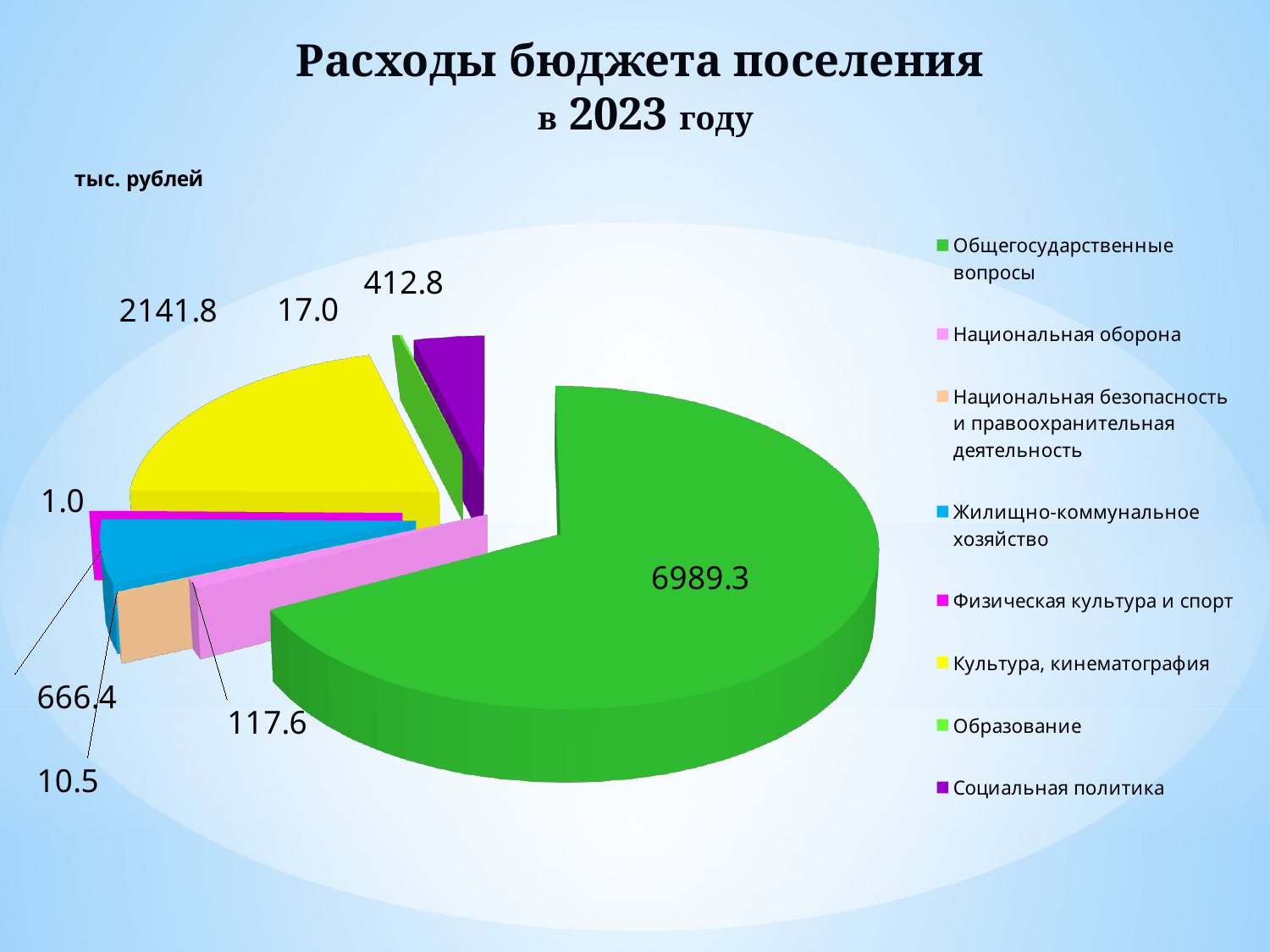
What is the value for Социальная политика? 412.8 What is the value for Жилищно-коммунальное хозяйство? 666.4 What is the value for Национальная оборона? 117.6 What type of chart is shown on the slide? pie chart How many categories does the legend list? 8 Which is larger, the value for Социальная политика or the value for Национальная оборона? Социальная политика Which category has the smallest value? Физическая культура и спорт What unit is indicated for the values on the chart? тыс. рублей What is the difference between the values for Культура, кинематография and Жилищно-коммунальное хозяйство? 1475.4 Which category has the largest share of the pie? Общегосударственные вопросы What is the value for Культура, кинематография? 2141.8 What is the value for Общегосударственные вопросы? 6989.3